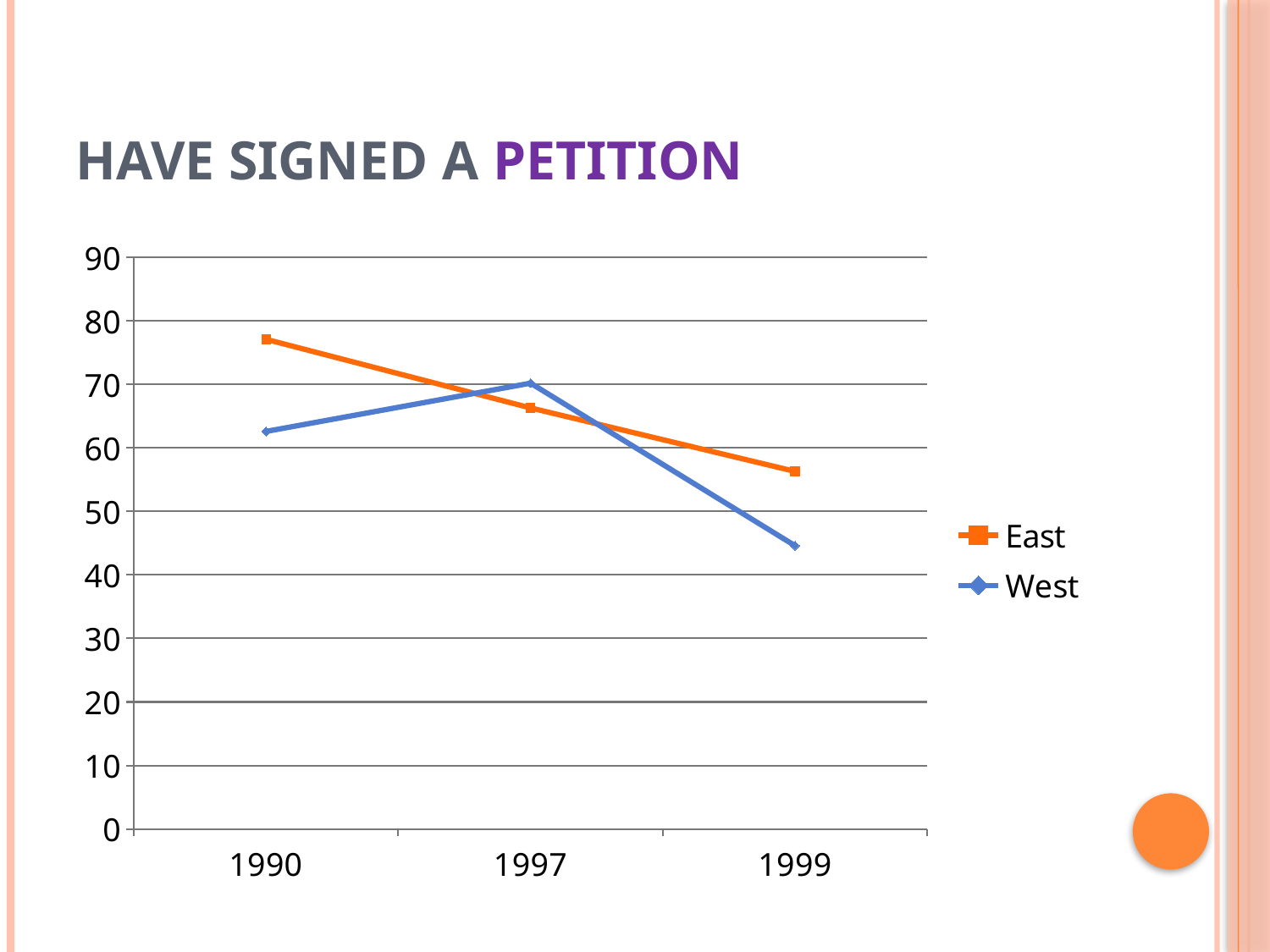
In which year does the West series reach its highest value? 1997 Is the value for West in 1999 greater or less than 50? less In 1999, which series has the larger value, East or West? East Is the value for East in 1999 greater or less than 50? greater How many series does the legend list? 2 Does the East series rise or fall from 1990 to 1999? fall What is the title of the slide? HAVE SIGNED A PETITION Is the value for West in 1990 greater or less than 70? less How many years are shown on the x axis? 3 In 1990, which series has the larger value, East or West? East What kind of chart is shown on the slide? line chart